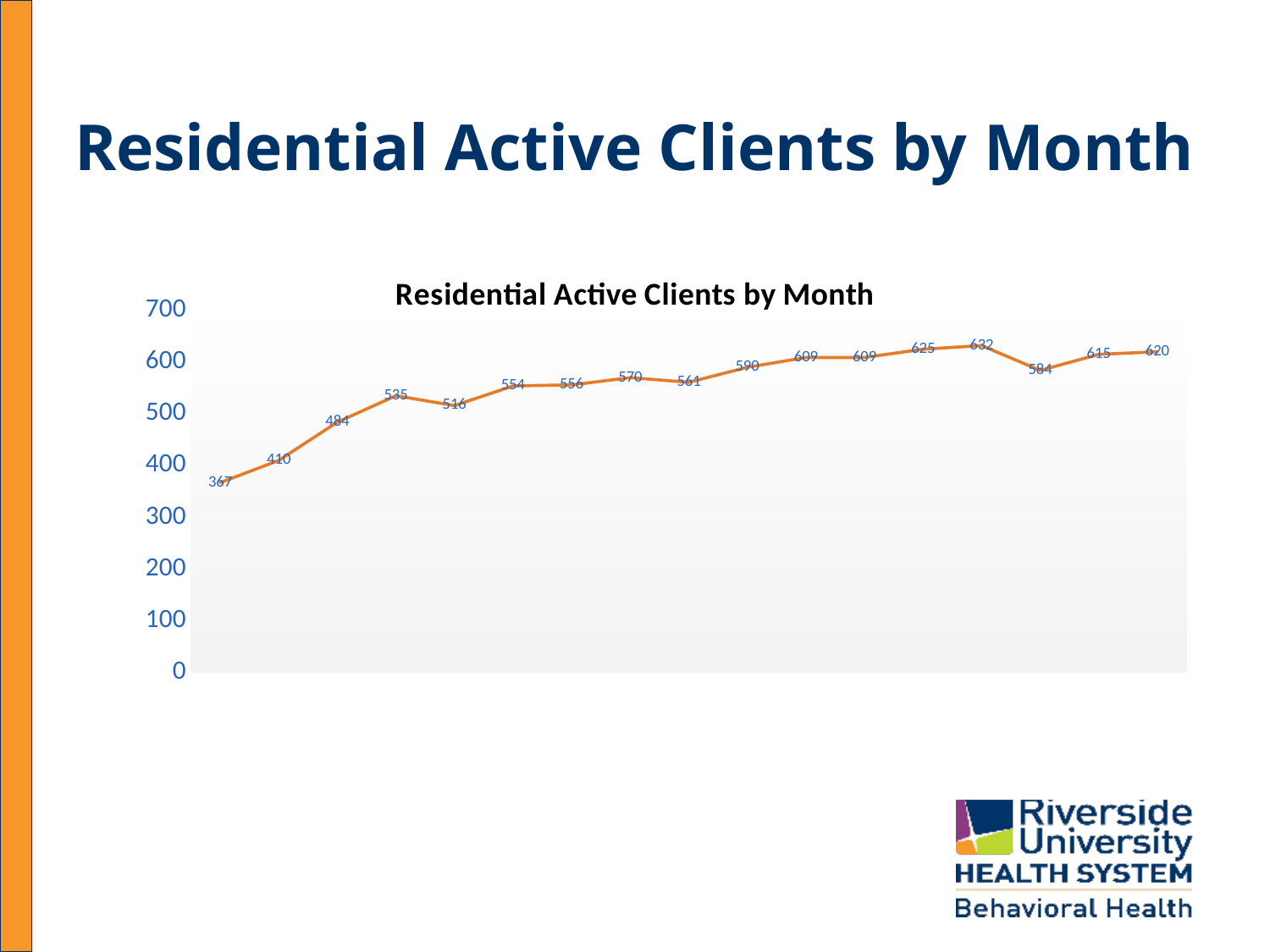
What is the value of the last data point on the line? 620 What is the difference between the last data point (620) and the first data point (367)? 253 What is the lowest value shown on the chart? 367 Is the value of the first data point greater or less than 400? less What kind of chart is shown on the slide? line chart What is the highest value shown on the chart? 632 What is the title of the chart? Residential Active Clients by Month What is the value of the first data point on the line? 367 How many data points are plotted on the line? 17 What is the difference between the highest value (632) and the lowest value (367) on the chart? 265 Do the values generally rise or fall from left to right along the x axis? rise Is the last data point higher or lower than the first data point? higher